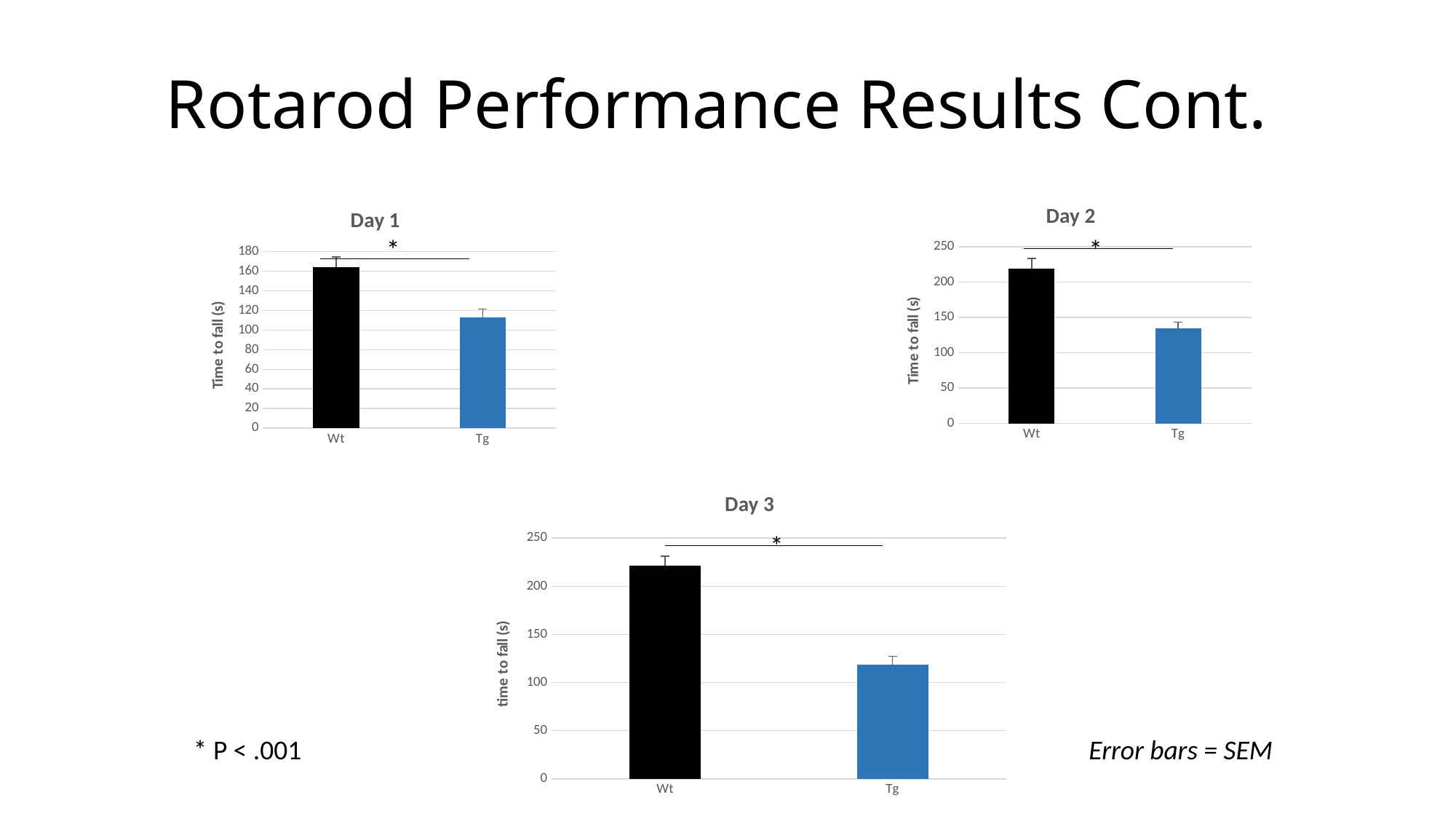
In the Day 1 chart, is the value for Tg greater or less than 140? less In the Day 2 chart, is the value for Tg greater or less than 150? less In the Day 3 chart, is the value for Wt greater or less than 200? greater In the Day 1 chart, which category has the higher time to fall, Wt or Tg? Wt What kind of chart is the Day 3 chart? Bar chart In the Day 2 chart, which category has the lowest time to fall? Tg What is the y-axis label of the Day 1 chart? Time to fall (s) In the Day 3 chart, which category has the highest time to fall? Wt How many categories are shown on the x axis of the Day 2 chart? 2